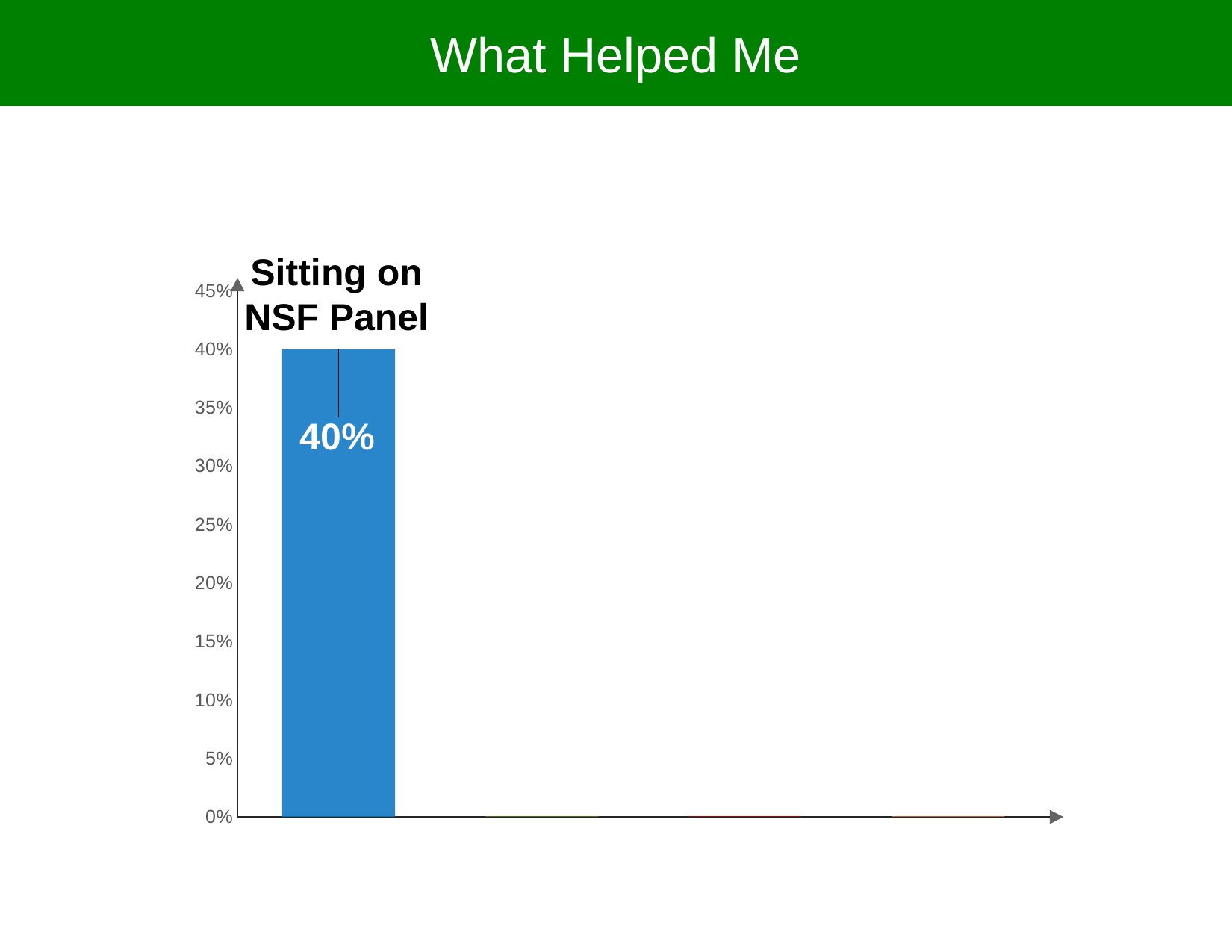
How many bars are plotted on the chart? 1 What is the title of the slide? What Helped Me What is the highest value shown on the vertical axis? 45% What is the label of the bar shown on the chart? Sitting on NSF Panel Is the value for Sitting on NSF Panel greater or less than 45%? less What kind of chart is shown on the slide? bar chart What is the value for Sitting on NSF Panel? 40% Is the value for Sitting on NSF Panel greater or less than 30%? greater